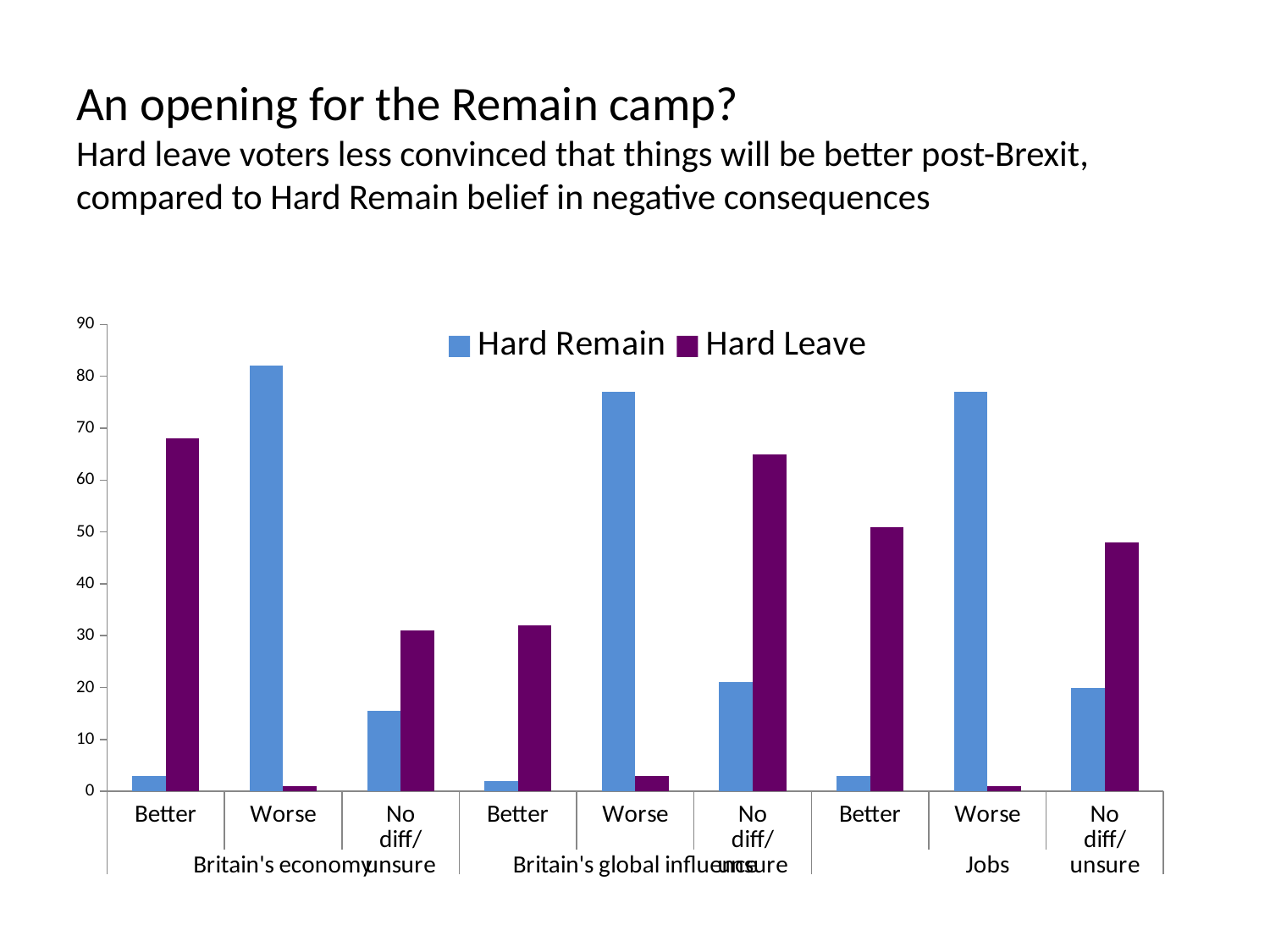
Which category has the highest Hard Leave value? Better (Britain's economy) For Better under Jobs, which series has the larger value, Hard Remain or Hard Leave? Hard Leave Which category has the highest Hard Remain value? Worse (Britain's economy) What are the two series named in the legend? Hard Remain and Hard Leave Is the Hard Remain value for No diff/unsure under Jobs greater or less than 30? less Is the Hard Leave value for No diff/unsure under Britain's global influence greater or less than 60? greater What kind of chart is shown on the slide? bar chart How many categories are plotted along the x axis? 9 For Worse under Britain's global influence, which series has the larger value, Hard Remain or Hard Leave? Hard Remain How many series does the legend list? 2 Is the Hard Remain value for Worse under Britain's economy greater or less than 80? greater